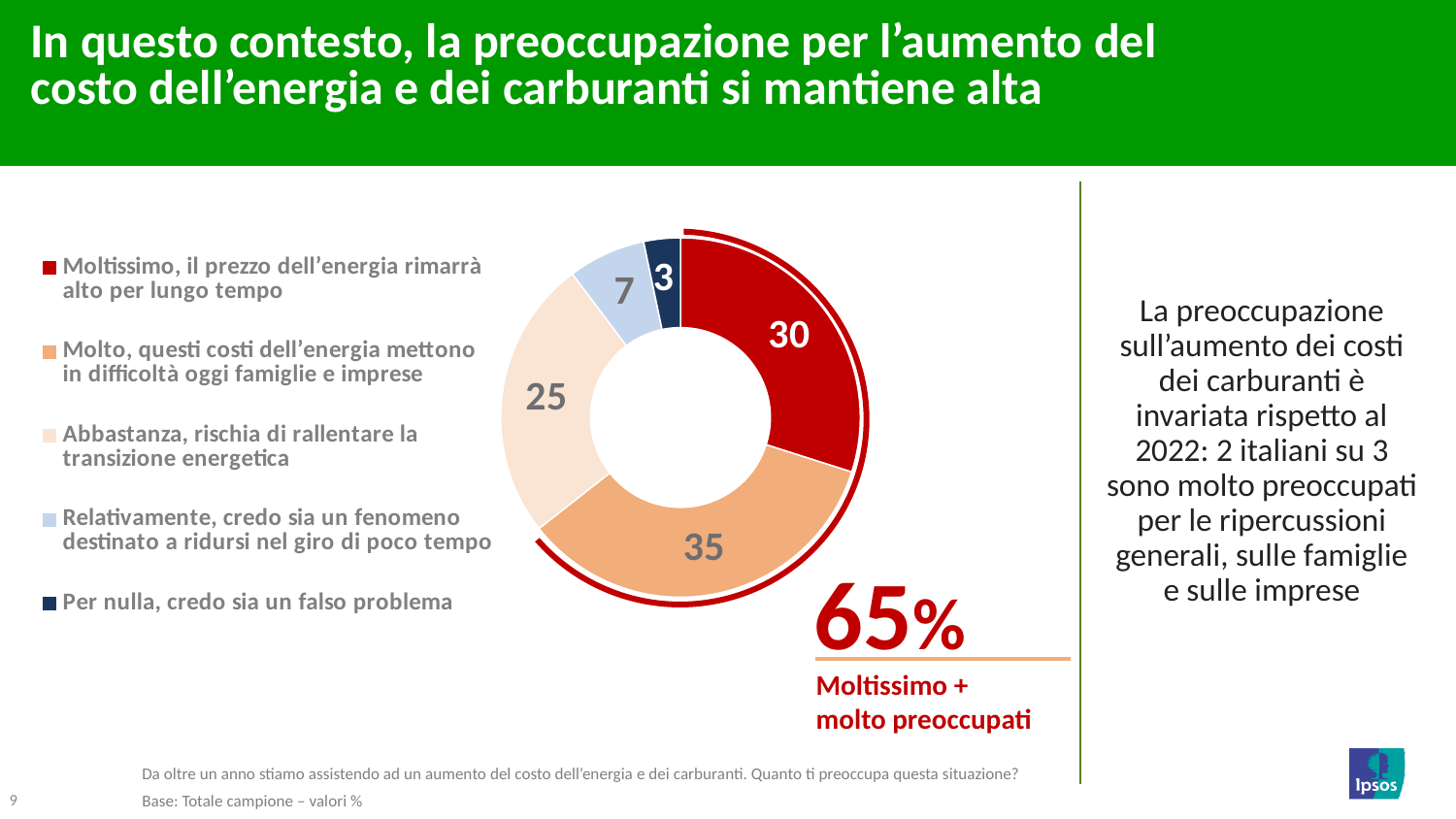
What is the value for "Per nulla, credo sia un falso problema"? 3 What is the value for "Molto, questi costi dell'energia mettono in difficoltà oggi famiglie e imprese"? 35 What is the value for "Abbastanza, rischia di rallentare la transizione energetica"? 25 What is the difference between the "Molto" slice and the "Moltissimo" slice? 5 How many categories does the legend list? 5 What combined percentage is highlighted next to the chart for "Moltissimo + molto preoccupati"? 65% Which category has the largest slice in the chart? Molto, questi costi dell'energia mettono in difficoltà oggi famiglie e imprese What kind of chart is shown on the slide? Donut (pie) chart What colour is the slice for "Moltissimo, il prezzo dell'energia rimarrà alto per lungo tempo"? Red Which category has the smallest slice in the chart? Per nulla, credo sia un falso problema What is the value for "Moltissimo, il prezzo dell'energia rimarrà alto per lungo tempo"? 30 Which is larger, the "Abbastanza" slice or the "Relativamente" slice? Abbastanza